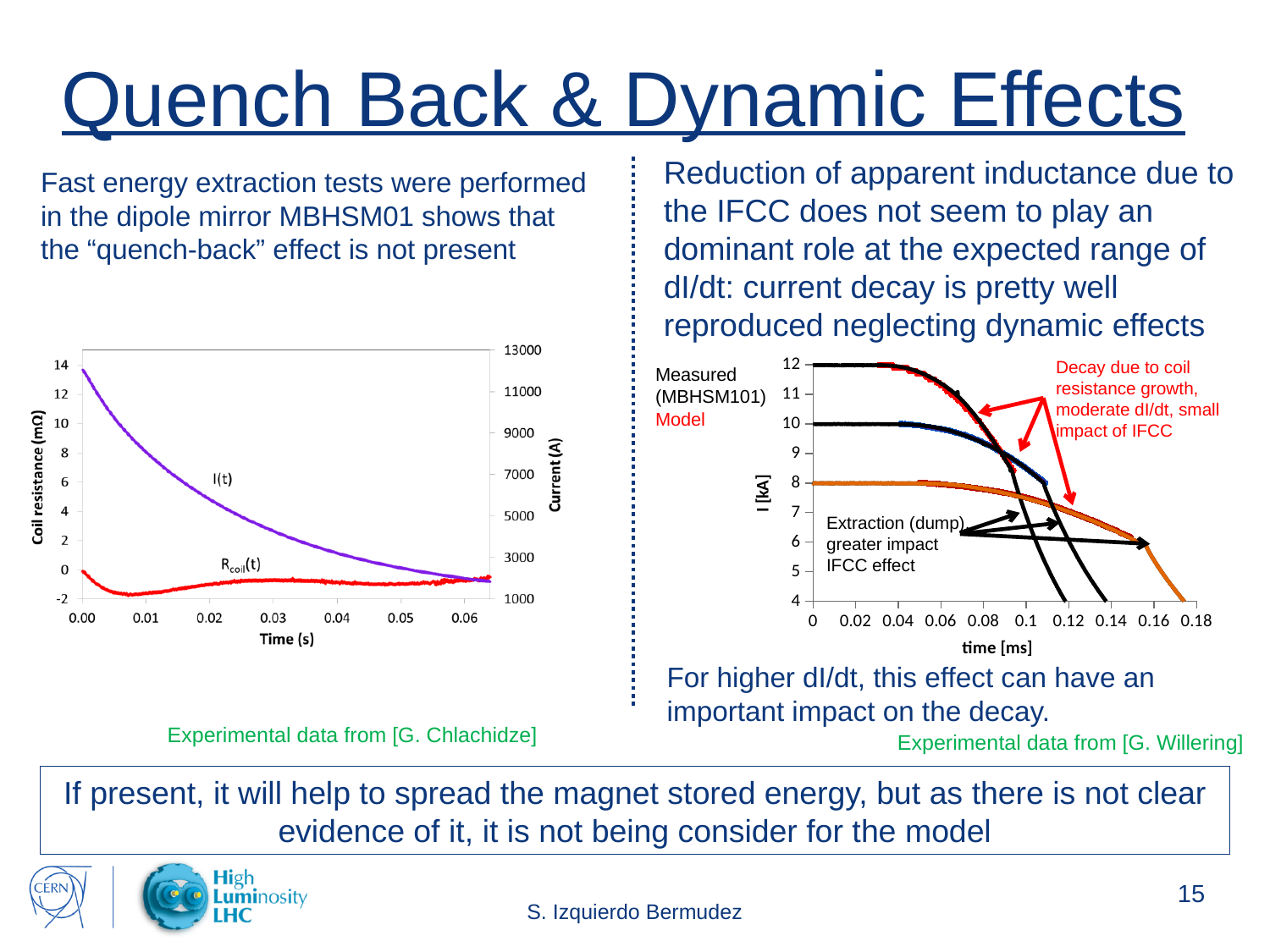
In the right chart, what is the highest initial current among the plotted curves? 12 kA In the left chart, what is the label of the x axis? Time (s) In the left chart, is the value of I(t) at time 0.00 s greater or less than 11000 A? greater In the left chart, how many curves are plotted? 2 In the left chart, is the value of I(t) at time 0.06 s greater or less than 3000 A? less In the right chart, which curve reaches 4 kA first: the one starting at 12 kA or the one starting at 8 kA? the one starting at 12 kA What kind of chart is the left chart showing coil resistance and current versus time? line chart In the left chart, does the I(t) curve rise or fall as time increases? fall In the right chart, what is the lowest initial current among the plotted curves? 8 kA In the right chart, what colour is used for the Model curves according to the legend? red